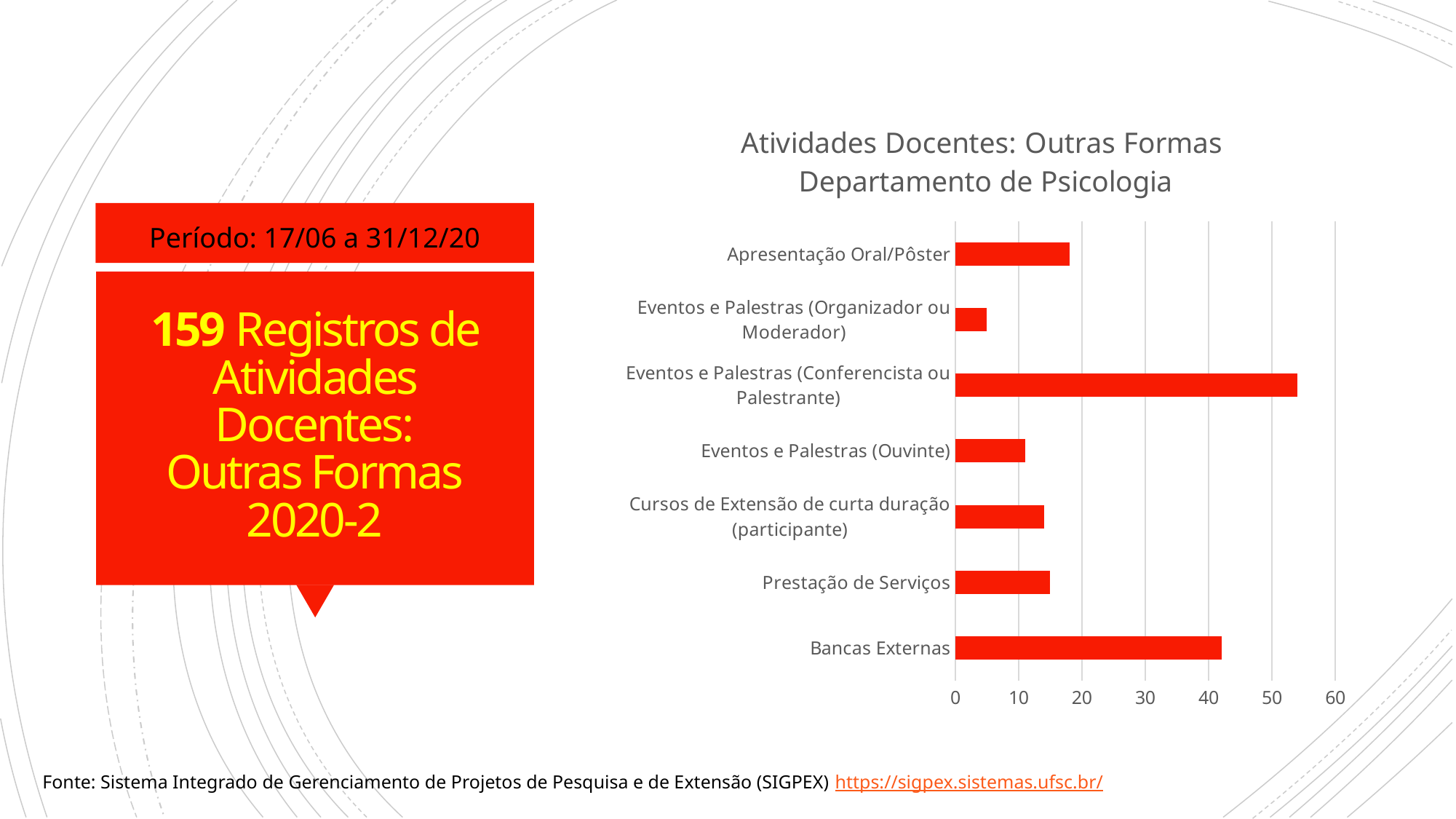
Is the value for Apresentação Oral/Pôster greater or less than 20? less What kind of chart is shown on the slide? bar chart Which category has the highest value in the chart? Eventos e Palestras (Conferencista ou Palestrante) Which category has the lowest value in the chart? Eventos e Palestras (Organizador ou Moderador) How many categories does the chart show? 7 What is the title of the chart? Atividades Docentes: Outras Formas Departamento de Psicologia Is the value for Bancas Externas greater or less than 40? greater Which is larger, the value for Eventos e Palestras (Ouvinte) or the value for Eventos e Palestras (Organizador ou Moderador)? Eventos e Palestras (Ouvinte) Which is larger, the value for Bancas Externas or the value for Apresentação Oral/Pôster? Bancas Externas Is the value for Eventos e Palestras (Conferencista ou Palestrante) greater or less than 50? greater